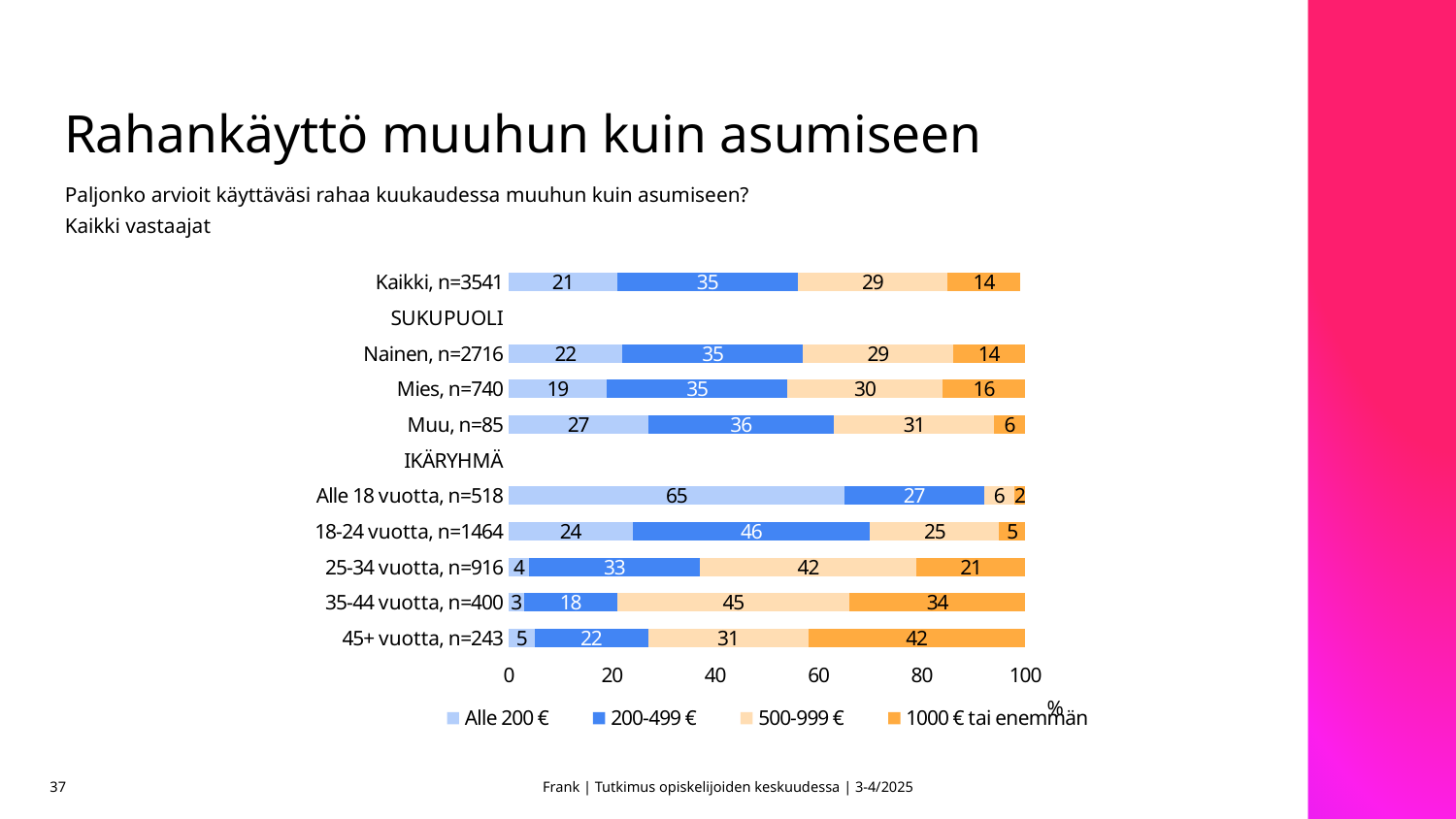
What is the value for '500-999 €' in the '35-44 vuotta, n=400' bar? 45 Which category has the highest value for 'Alle 200 €'? Alle 18 vuotta, n=518 What is the value for '1000 € tai enemmän' in the '45+ vuotta, n=243' bar? 42 What is the value for 'Alle 200 €' in the 'Kaikki, n=3541' bar? 21 Which is larger: the '1000 € tai enemmän' value for 'Mies, n=740' or for 'Nainen, n=2716'? Mies, n=740 What kind of chart is shown on the slide? Stacked bar chart What is the value for '200-499 €' in the 'Muu, n=85' bar? 36 How many series does the legend list? 4 What is the difference between the '200-499 €' values for '18-24 vuotta, n=1464' and '25-34 vuotta, n=916'? 13 What is the last legend entry in the chart? 1000 € tai enemmän How many categories (bars) are plotted in the chart? 9 Which category has the lowest value for '1000 € tai enemmän'? Alle 18 vuotta, n=518